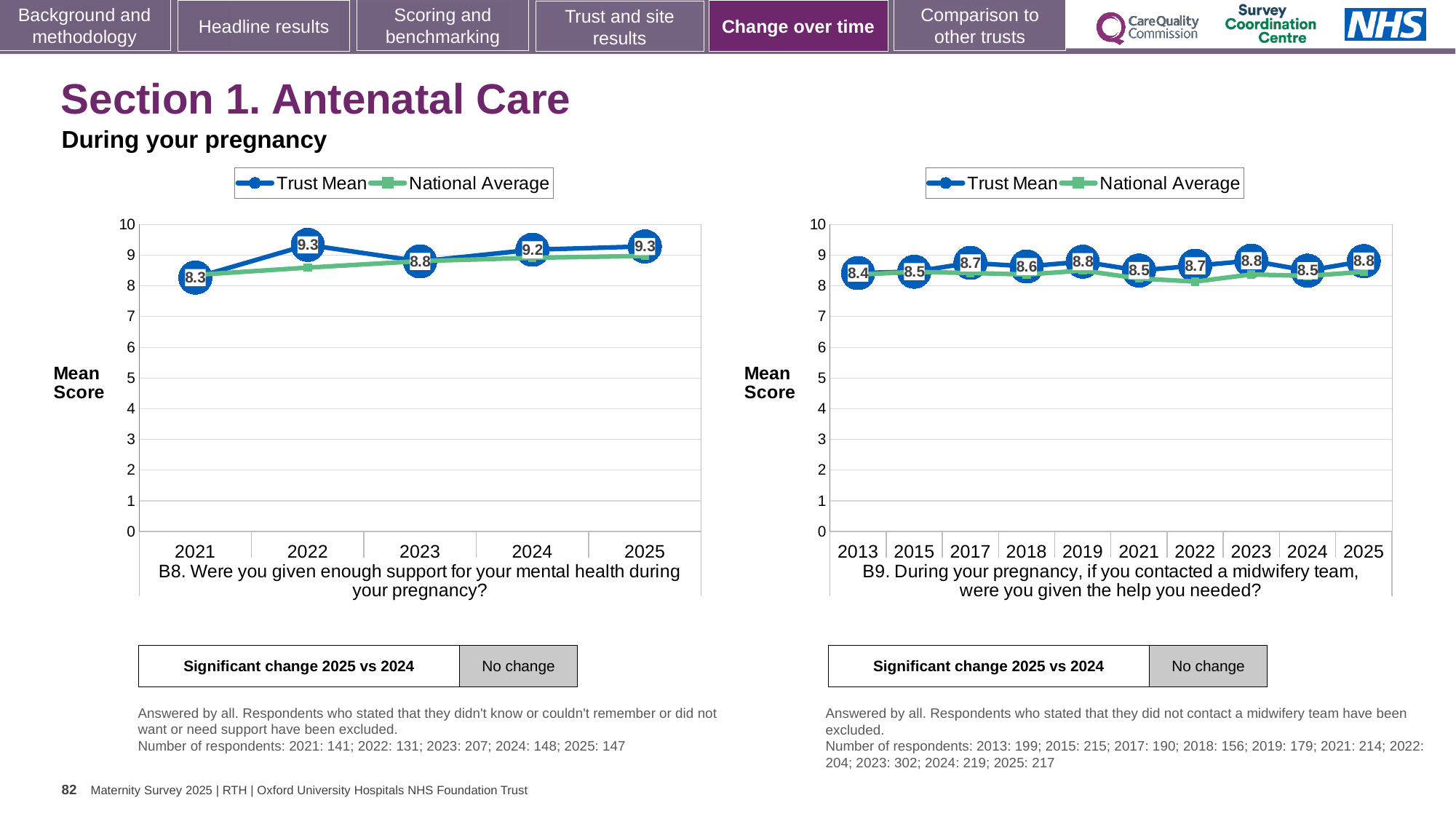
On the B9 chart (right), what is the Trust Mean for 2013? 8.4 On the B8 chart (left), what is the difference between the Trust Mean for 2022 and 2021? 1.0 On the B8 chart (left), what is the Trust Mean for 2021? 8.3 On the B9 chart (right), what is the Trust Mean for 2025? 8.8 On the B8 chart (left), what is the Trust Mean for 2024? 9.2 On the B8 chart (left), which year has the lowest Trust Mean? 2021 On the B9 chart (right), which is larger, the Trust Mean for 2019 or for 2021? 2019 On the B9 chart (right), is the Trust Mean for 2018 greater or less than 8? greater On the B8 chart (left), how many years are shown on the x axis? 5 How many series does the legend of the B8 chart (left) list? 2 What kind of chart is the B9 chart (right)? Line chart On the B9 chart (right), how many years are shown on the x axis? 10